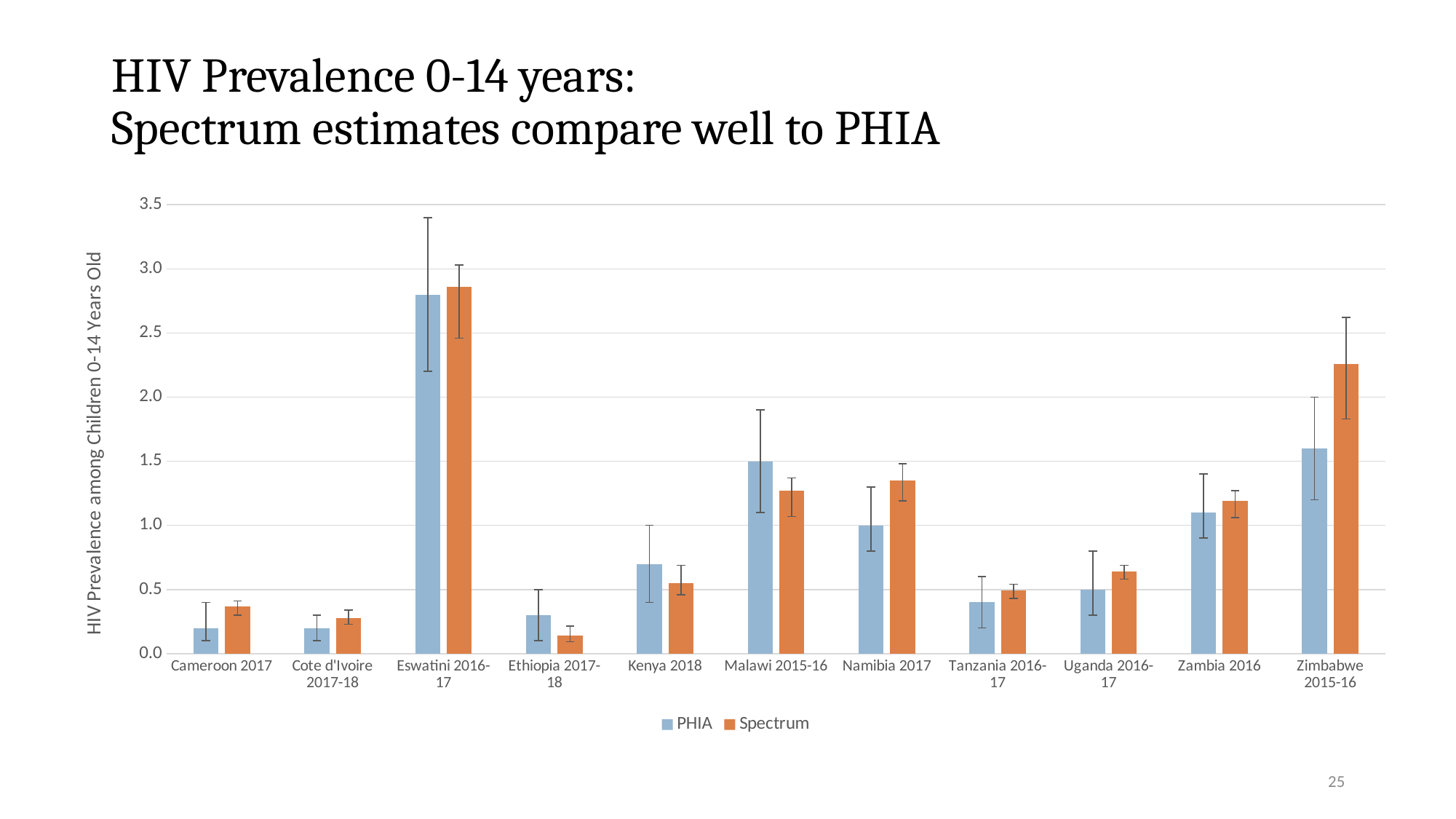
For Zimbabwe 2015-16, which is larger, the PHIA value or the Spectrum value? Spectrum Is the PHIA value for Eswatini 2016-17 greater or less than 2.5? greater What kind of chart is shown on the slide? bar chart For Malawi 2015-16, which is larger, the PHIA value or the Spectrum value? PHIA What is the PHIA value for Namibia 2017? 1.0 How many country categories are shown on the x axis? 11 Which country has the highest PHIA value? Eswatini 2016-17 What is the PHIA value for Malawi 2015-16? 1.5 Is the Spectrum value for Zimbabwe 2015-16 greater or less than 2.0? greater How many series does the legend list? 2 What is the title of the y axis? HIV Prevalence among Children 0-14 Years Old Which country has the lowest Spectrum value? Ethiopia 2017-18